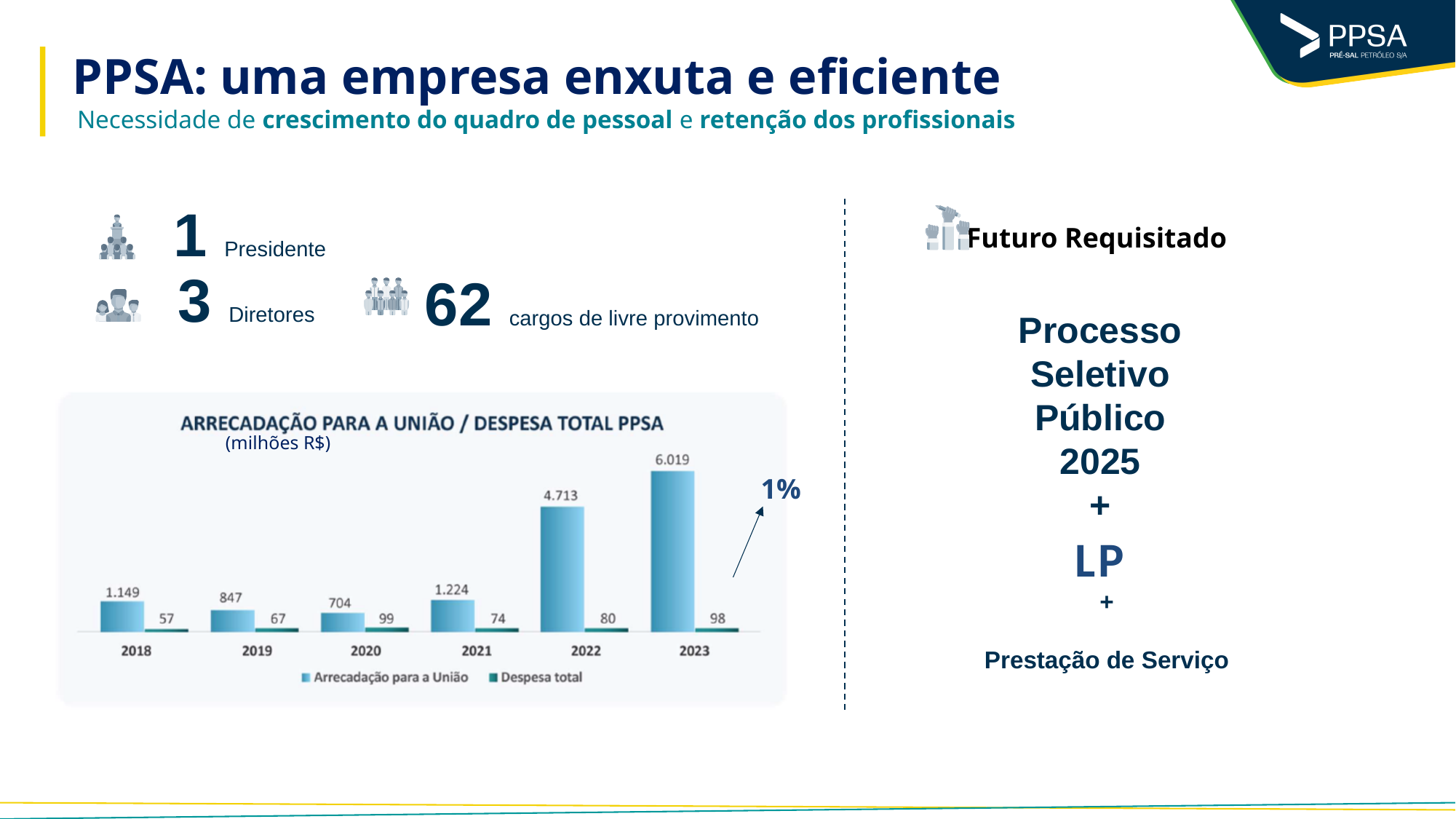
Which year has the lowest Despesa total? 2018 What is the Despesa total value for 2020? 99 Which is larger, Despesa total in 2021 or Despesa total in 2022? 2022 How many series does the chart legend list? 2 What is the difference between Arrecadação para a União in 2022 and in 2021? 3.489 Which year has the highest Arrecadação para a União? 2023 What is the value of Arrecadação para a União for 2023? 6.019 Which year has the lowest Arrecadação para a União? 2020 What type of chart is shown on the slide? Bar chart What is the Arrecadação para a União value for 2019? 847 How many years are shown on the x axis of the chart? 6 What is the difference between Despesa total in 2020 and in 2018? 42